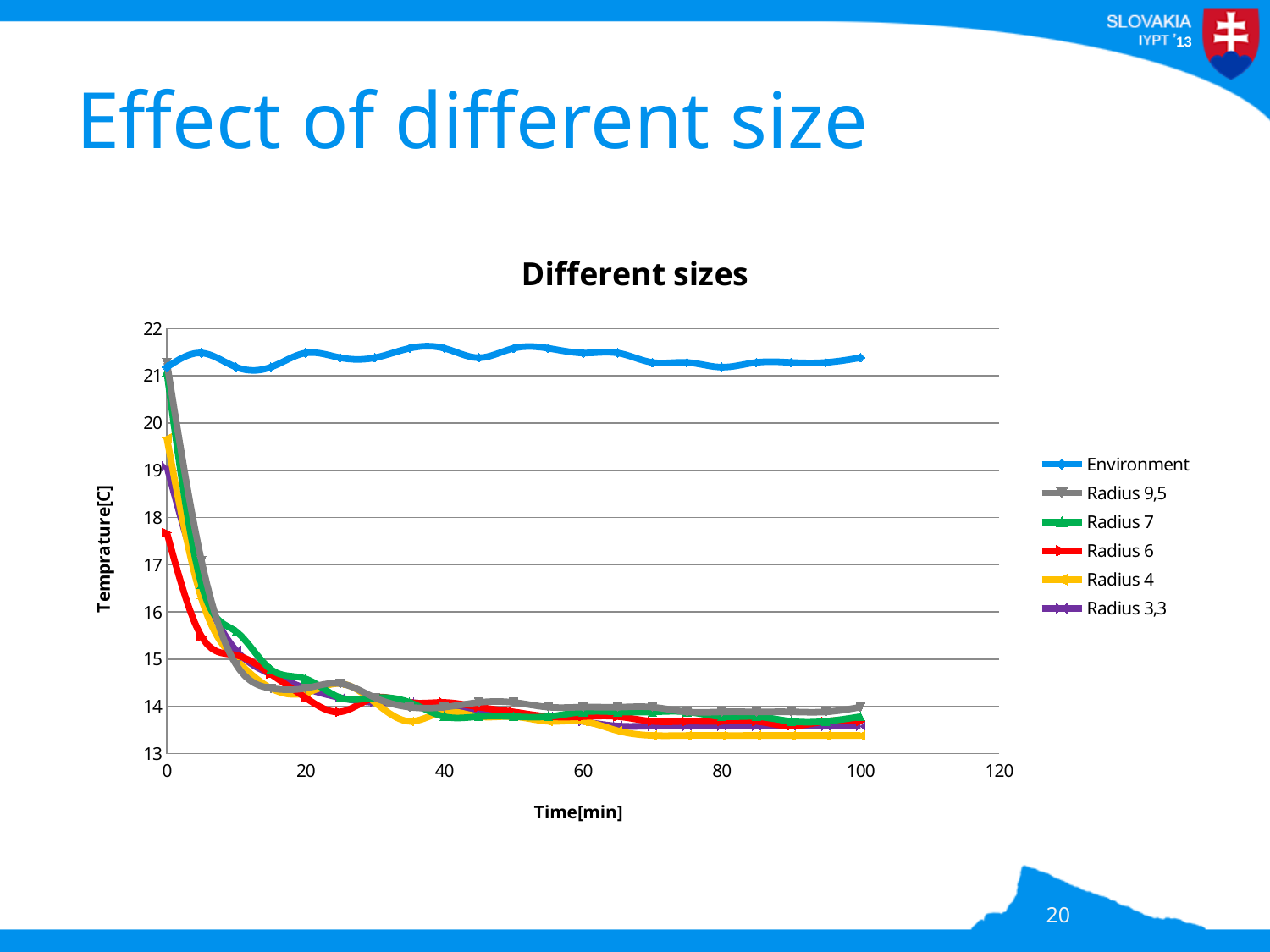
What is the label of the x axis? Time[min] Which series has the highest value at 100 min? Environment Is the value for Radius 4 at 0 min greater or less than 19? greater Is the value for Environment at 0 min greater or less than 20? greater At 0 min, which is higher: Radius 9,5 or Radius 6? Radius 9,5 Does the Radius 9,5 series rise or fall as time increases? fall What is the title of the chart? Different sizes What kind of chart is shown on the slide? line chart Is the value for Radius 3,3 at 0 min greater or less than 18? greater How many series does the legend list? 6